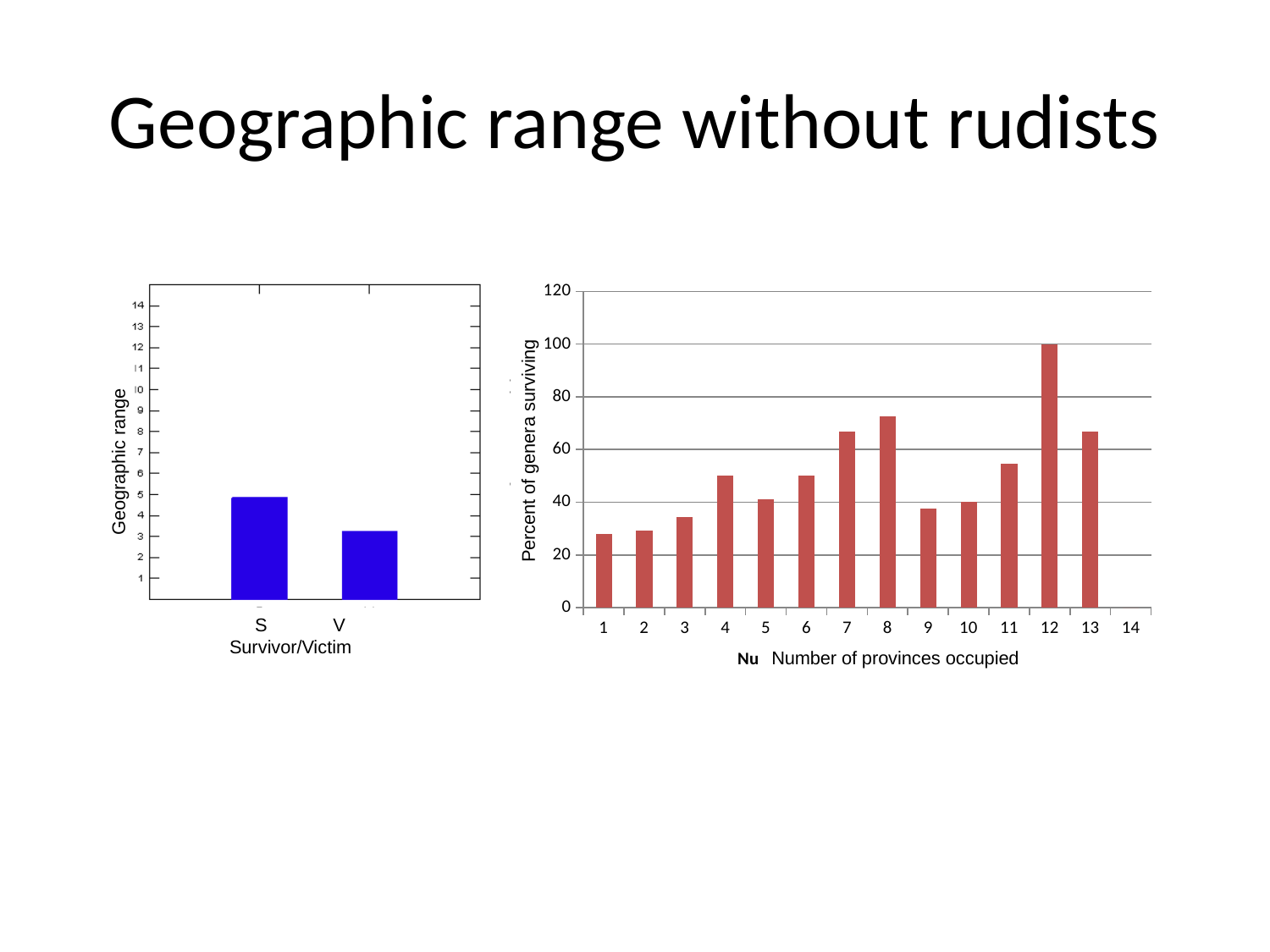
In the left-hand chart, is the geographic range for S greater or less than 4? greater In the right-hand chart, is the value for 1 province occupied greater or less than 40? less In the left-hand chart, which category has the larger geographic range, S or V? S In the left-hand chart, is the geographic range for V greater or less than 4? less In the right-hand chart, what is the percent of genera surviving for 12 provinces occupied? 100 What kind of chart is the right-hand chart (Percent of genera surviving)? bar chart In the right-hand chart, how many categories are shown on the x axis? 14 What is the x-axis label of the right-hand chart? Number of provinces occupied In the right-hand chart, which number of provinces occupied has the highest percent of genera surviving? 12 In the right-hand chart, which has a higher percent of genera surviving: 8 provinces or 9 provinces? 8